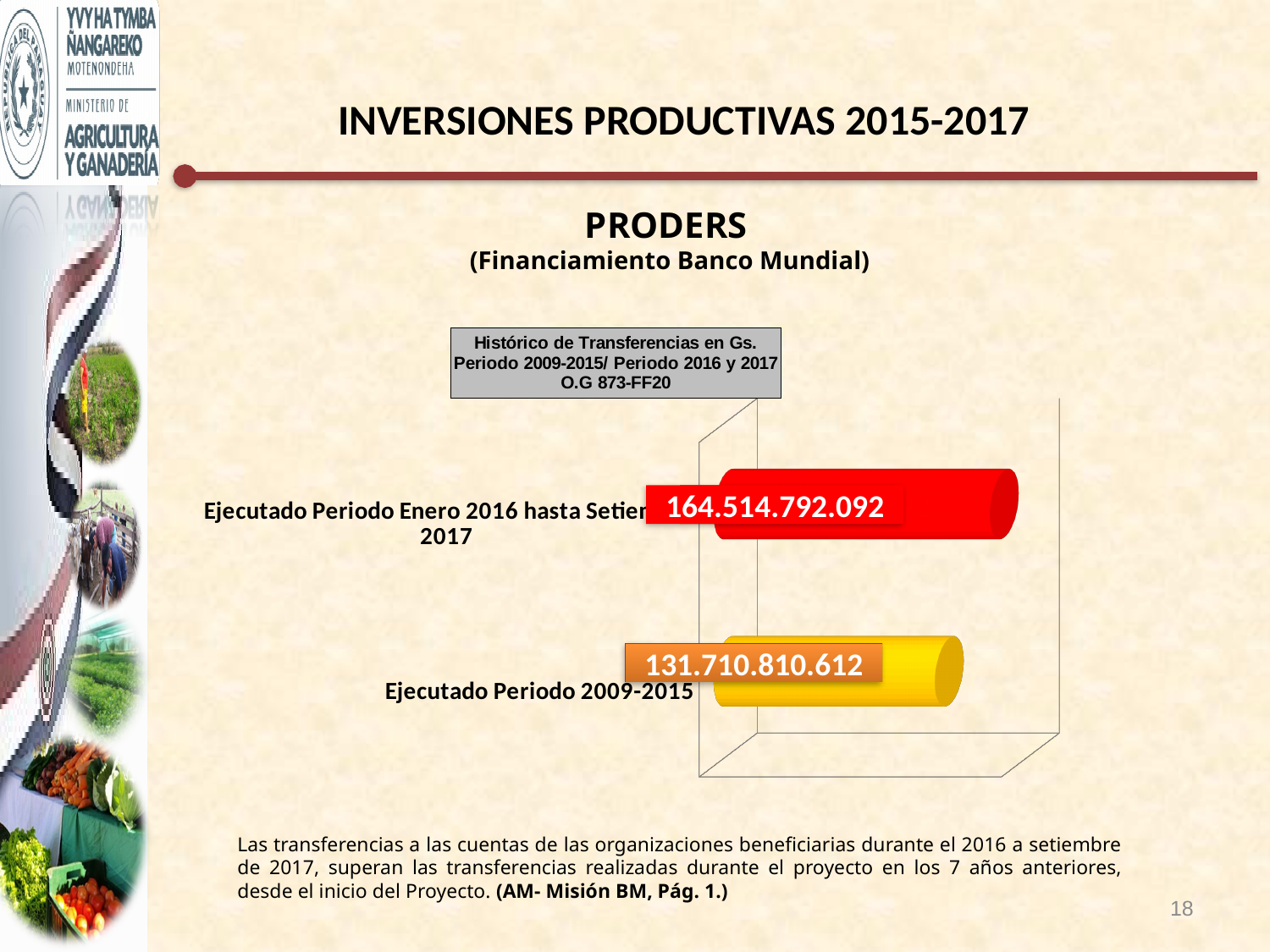
How many bars are plotted in the chart? 2 What kind of chart is shown on the slide? Bar chart Which period has the highest value in the chart? Ejecutado Periodo Enero 2016 hasta Setiembre 2017 What is the difference between the value for Enero 2016 hasta Setiembre 2017 and the value for 2009-2015? 32.803.981.480 What colour is the bar for Ejecutado Periodo 2009-2015? Yellow Which period has the lowest value in the chart? Ejecutado Periodo 2009-2015 What is the title of the chart? Histórico de Transferencias en Gs. Periodo 2009-2015/ Periodo 2016 y 2017 O.G 873-FF20 What is the value for Ejecutado Periodo 2009-2015? 131.710.810.612 Which is larger: the value for Ejecutado Periodo 2009-2015 or the value for Ejecutado Periodo Enero 2016 hasta Setiembre 2017? Ejecutado Periodo Enero 2016 hasta Setiembre 2017 What is the value for Ejecutado Periodo Enero 2016 hasta Setiembre 2017? 164.514.792.092